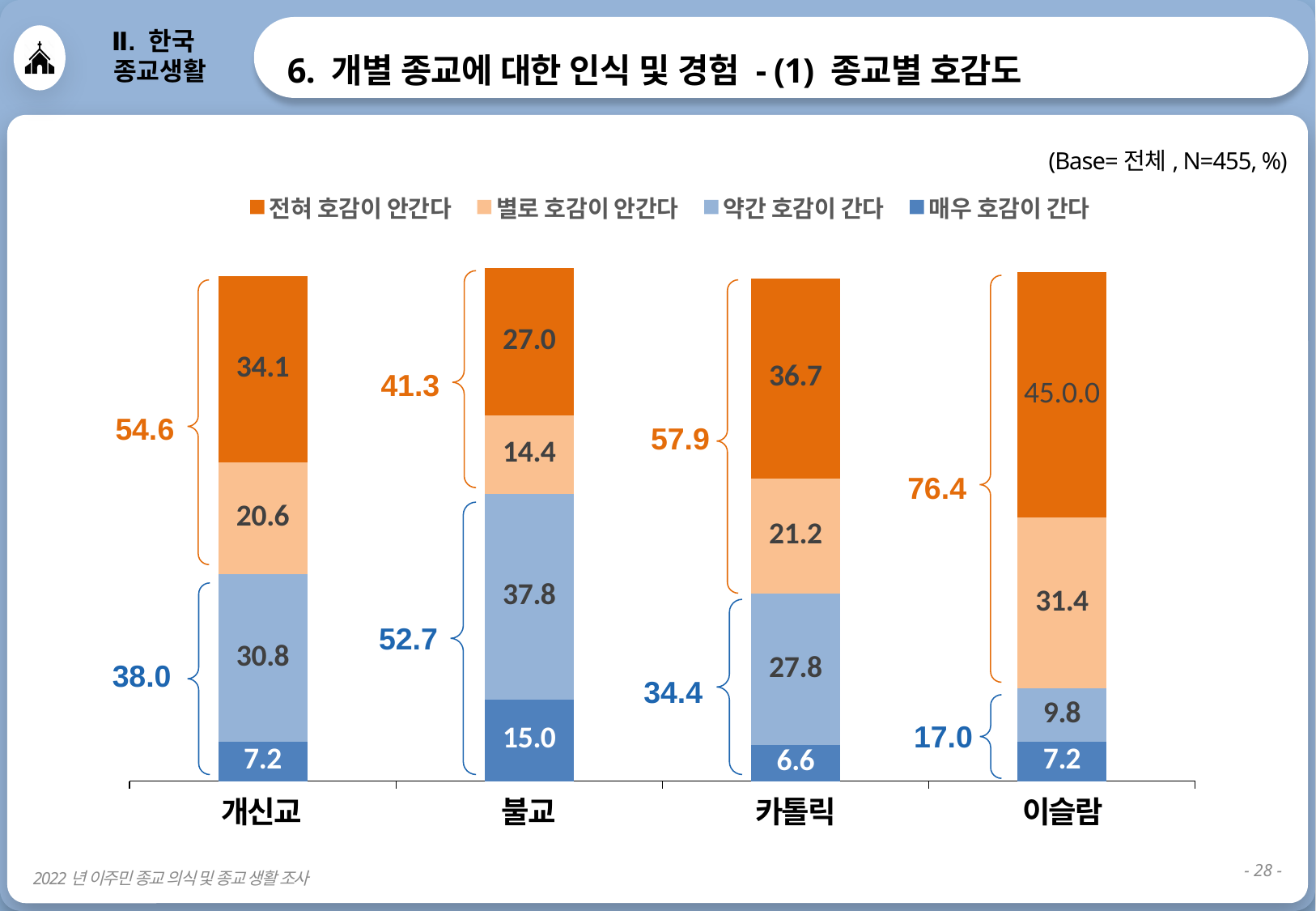
How many religions (categories) are shown on the x axis? 4 What is the value of 매우 호감이 간다 for 불교? 15.0 What is the combined unfavorable (orange bracket) value shown for 이슬람? 76.4 How many series does the legend list? 4 What is the value of 별로 호감이 안간다 for 이슬람? 31.4 What is the difference between the 약간 호감이 간다 values for 불교 and 개신교? 7.0 What kind of chart is shown on the slide? stacked bar chart Which is larger, the 별로 호감이 안간다 value for 개신교 or for 카톨릭? 카톨릭 What is the value of 전혀 호감이 안간다 for 카톨릭? 36.7 Which religion has the highest value for 매우 호감이 간다? 불교 Which religion has the lowest value for 매우 호감이 간다? 카톨릭 Which religion has the highest value for 전혀 호감이 안간다? 이슬람